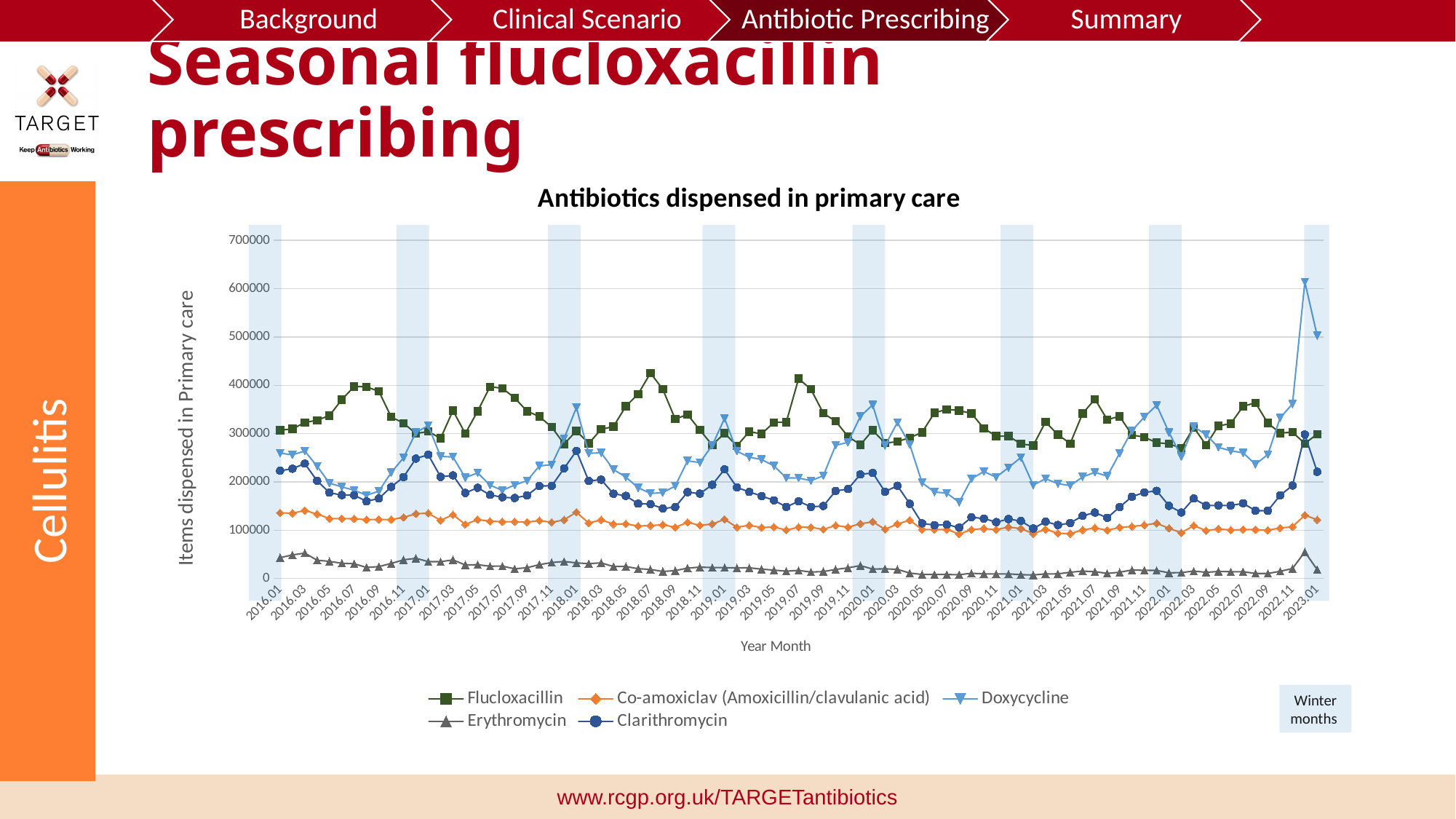
Does the Erythromycin series generally rise or fall from 2016.01 to 2022.11? fall Is the value for Doxycycline at 2022.11 greater or less than 500000? less Which series has the highest value at 2023.01? Doxycycline What is the title of the chart? Antibiotics dispensed in primary care What kind of chart is shown on the slide? line chart Is the value for Erythromycin at 2016.01 greater or less than 100000? less Which series has the lowest values across the whole period? Erythromycin Is the value for Flucloxacillin at 2018.07 greater or less than 400000? greater What do the shaded vertical bands on the chart represent? Winter months How many series does the legend list? 5 At 2016.01, which is larger: Flucloxacillin or Co-amoxiclav (Amoxicillin/clavulanic acid)? Flucloxacillin